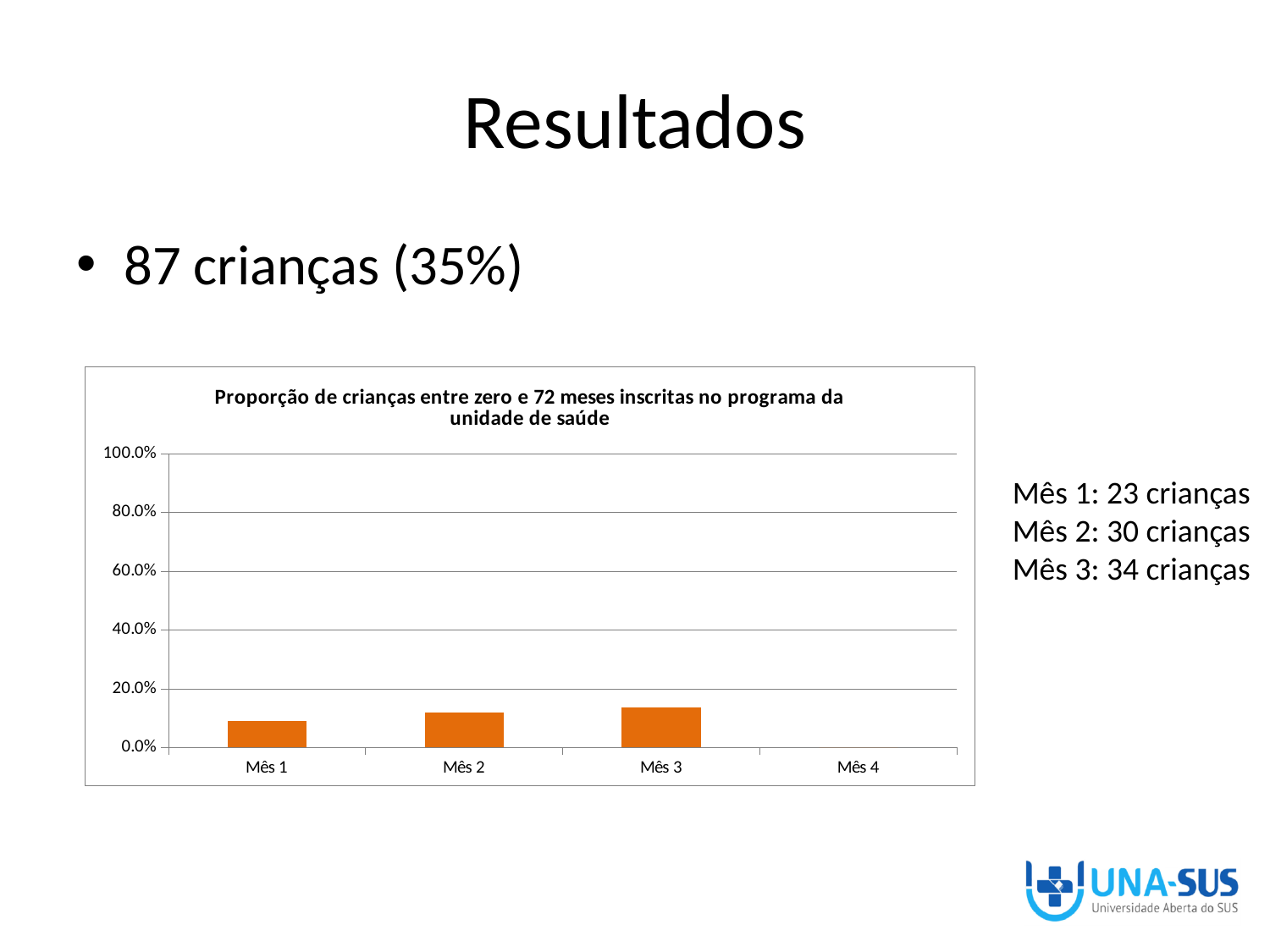
What kind of chart is shown on the slide? bar chart Is the value for Mês 3 greater or less than 20.0%? less Which month has the tallest bar in the chart? Mês 3 Is the value for Mês 2 greater or less than 40.0%? less Which is larger, the value for Mês 1 or the value for Mês 3? Mês 3 How many categories are shown on the x axis of the chart? 4 What is the highest value shown on the y axis of the chart? 100.0% Is the value for Mês 1 greater or less than 20.0%? less Among the months with a visible bar, which has the shortest bar? Mês 1 Which month on the x axis has no bar plotted? Mês 4 What is the title of the chart? Proporção de crianças entre zero e 72 meses inscritas no programa da unidade de saúde Do the bar values rise or fall from Mês 1 to Mês 3? rise